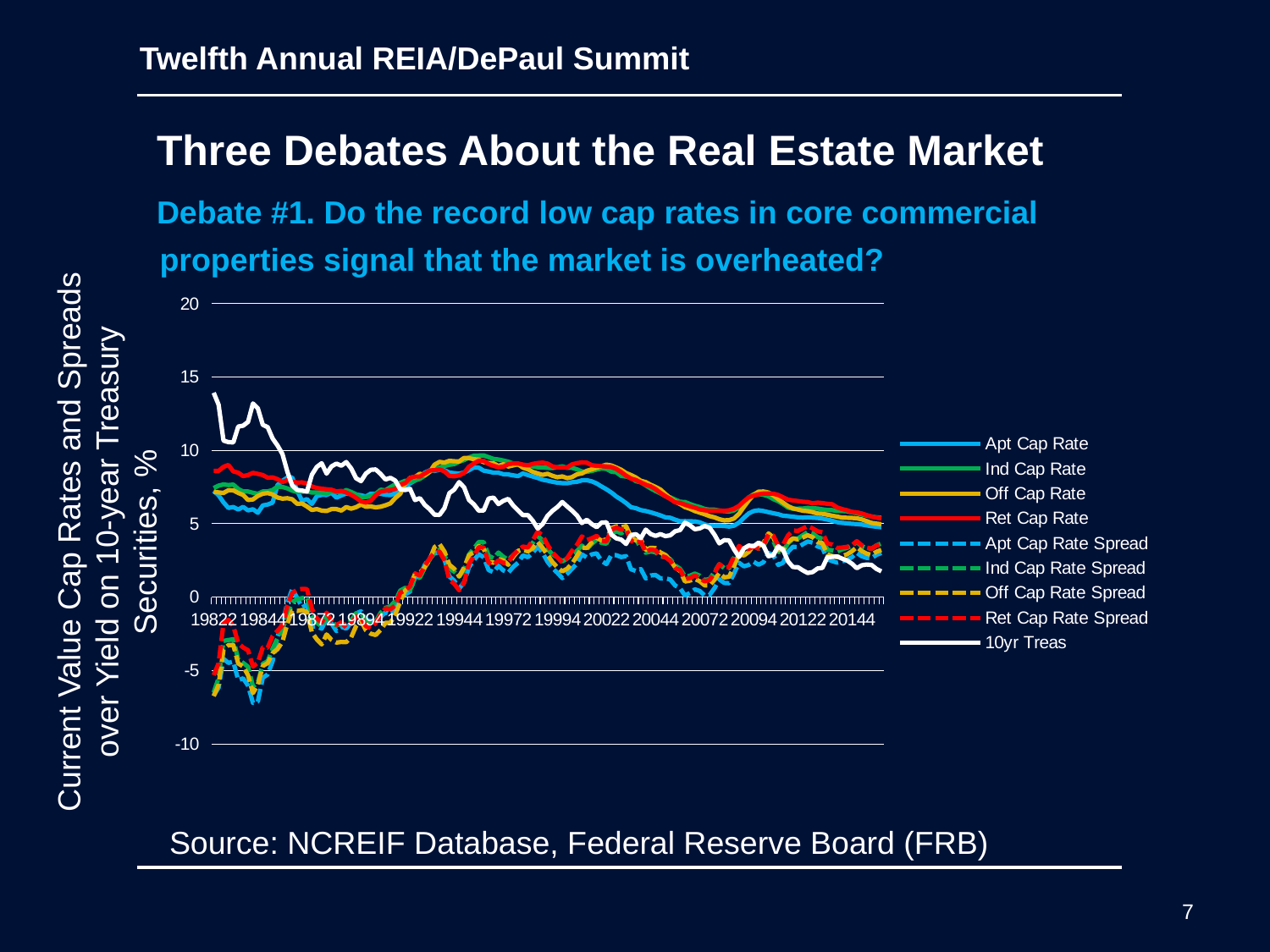
Is the value of the 10yr Treas series at the end of the chart (around 20144) greater or less than 5? less Does the 10yr Treas series generally rise or fall from 19822 to 20144? fall Which series in the legend is drawn as a solid white line? 10yr Treas How many series does the chart's legend list? 9 Is the Apt Cap Rate Spread at the start of the chart (19822) greater or less than 0? less Is the Apt Cap Rate at the end of the chart (around 20144) greater or less than 10? less What is the y-axis title of the chart? Current Value Cap Rates and Spreads over Yield on 10-year Treasury Securities, % Does the Off Cap Rate Spread series generally rise or fall from 19822 to 19944? rise How many labelled tick marks are shown on the x axis? 14 What kind of chart is shown on the slide? line chart